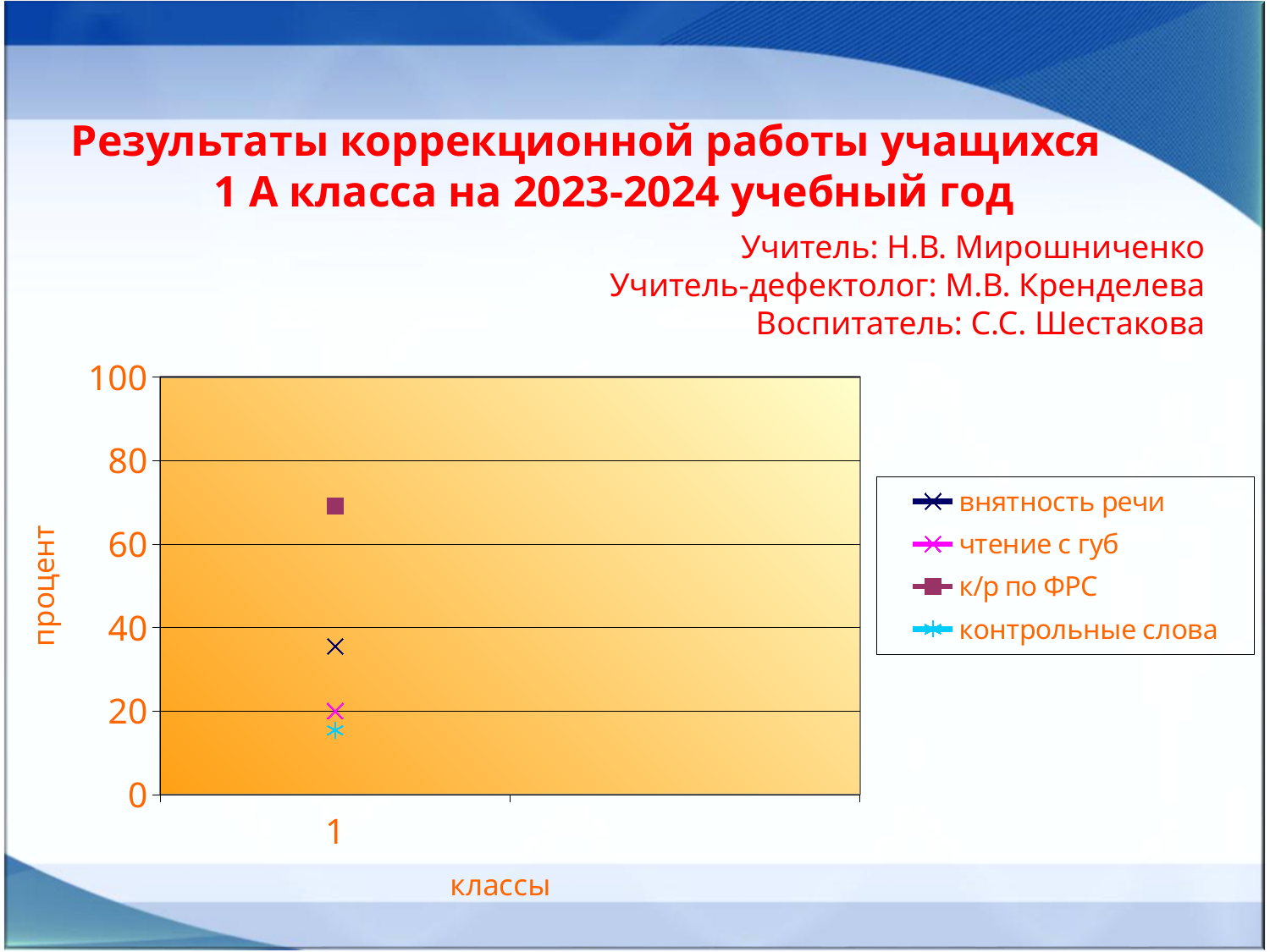
Which is larger for class 1: к/р по ФРС or внятность речи? к/р по ФРС How many categories are shown on the x axis? 1 Is the value for внятность речи greater or less than 20? greater What is the title of the horizontal axis? классы Is the value for внятность речи greater or less than 40? less What is the title of the vertical axis? процент How many series does the legend list? 4 Is the value for к/р по ФРС greater or less than 80? less Which series has the lowest value for class 1? контрольные слова Which series has the highest value for class 1? к/р по ФРС